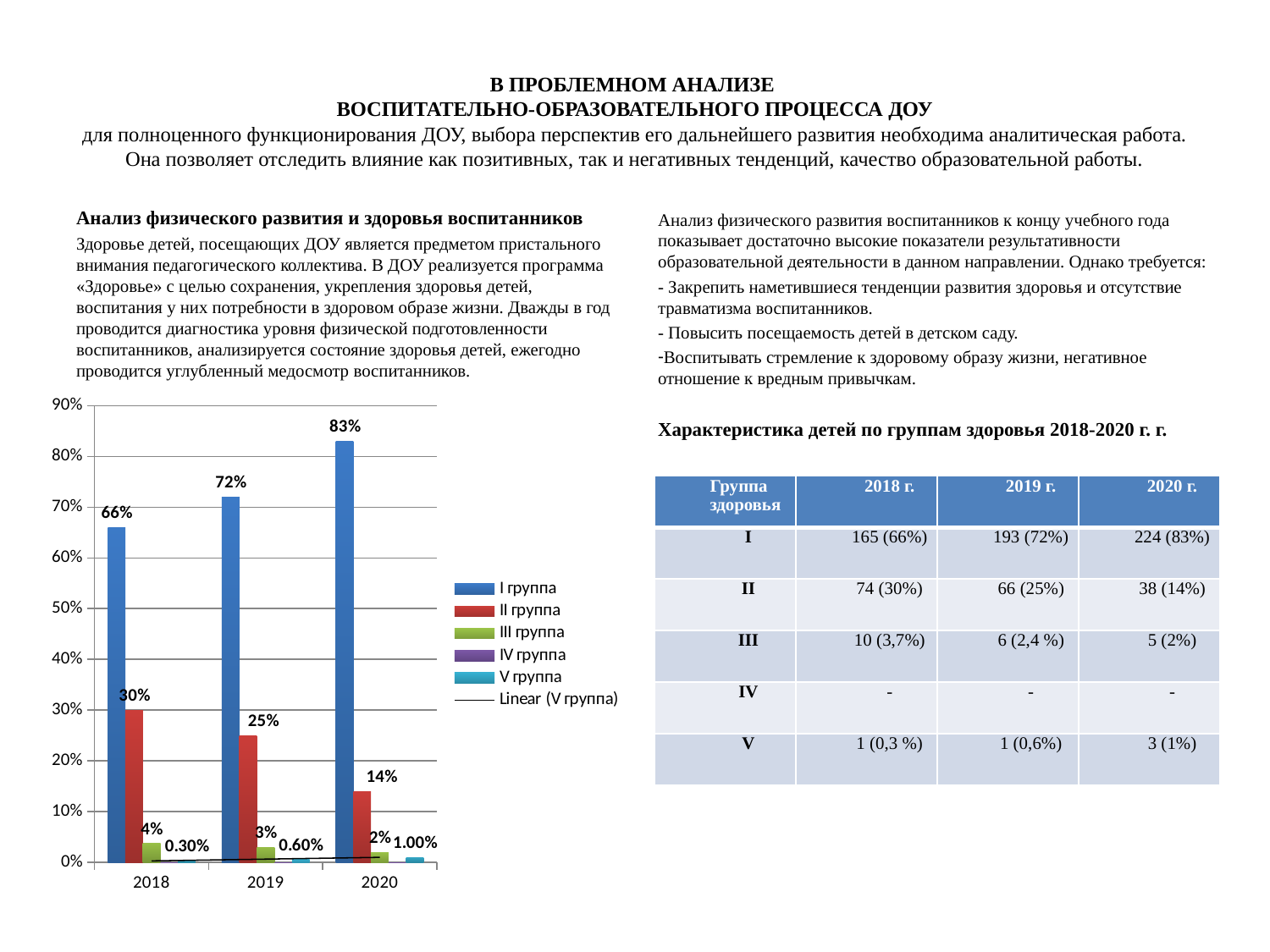
How many years are shown on the x axis of the chart? 3 What is the value for V группа in 2020? 1.00% What is the value for I группа in 2020? 83% What is the difference between the I группа values for 2020 and 2018? 17% What is the value for III группа in 2019? 3% What kind of chart is shown on the slide? bar chart Which is larger: II группа in 2019 or II группа in 2020? II группа in 2019 How many entries does the chart legend list? 6 In which year is the value for I группа highest? 2020 In which year is the value for II группа lowest? 2020 What is the value for II группа in 2018? 30% Do the values for I группа rise or fall from 2018 to 2020? rise